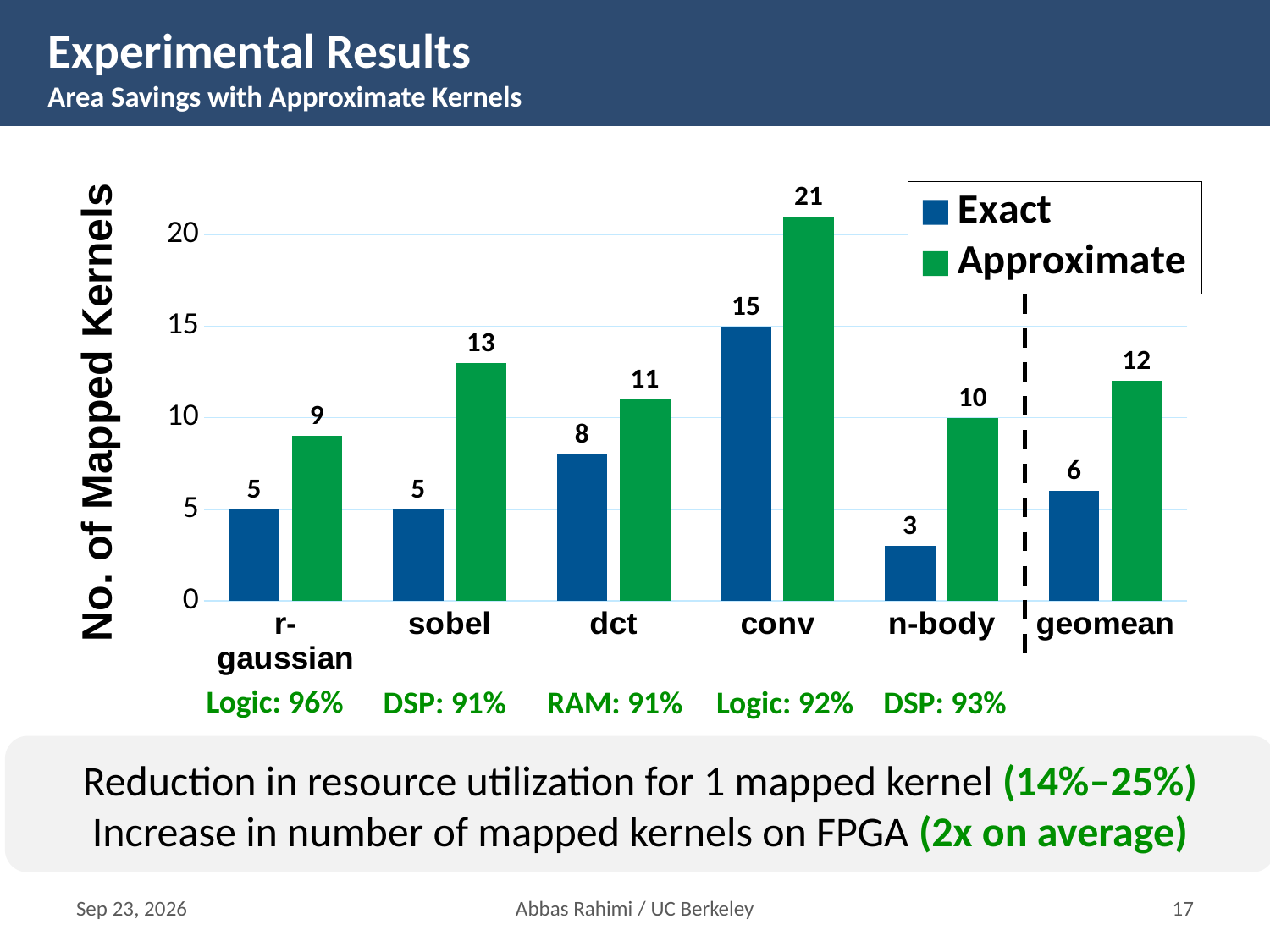
What is the y-axis title of the chart? No. of Mapped Kernels What is the Approximate value for sobel? 13 Which is larger: the Exact value for conv or the Approximate value for sobel? Exact value for conv What is the Approximate value for geomean? 12 Which category has the highest Approximate value? conv What is the difference between the Approximate and Exact values for n-body? 7 How many series does the legend list? 2 How many categories are shown on the x axis? 6 What is the Exact value for conv? 15 What kind of chart is shown on the slide? bar chart Which category has the lowest Exact value? n-body What is the difference between the Approximate and Exact values for dct? 3